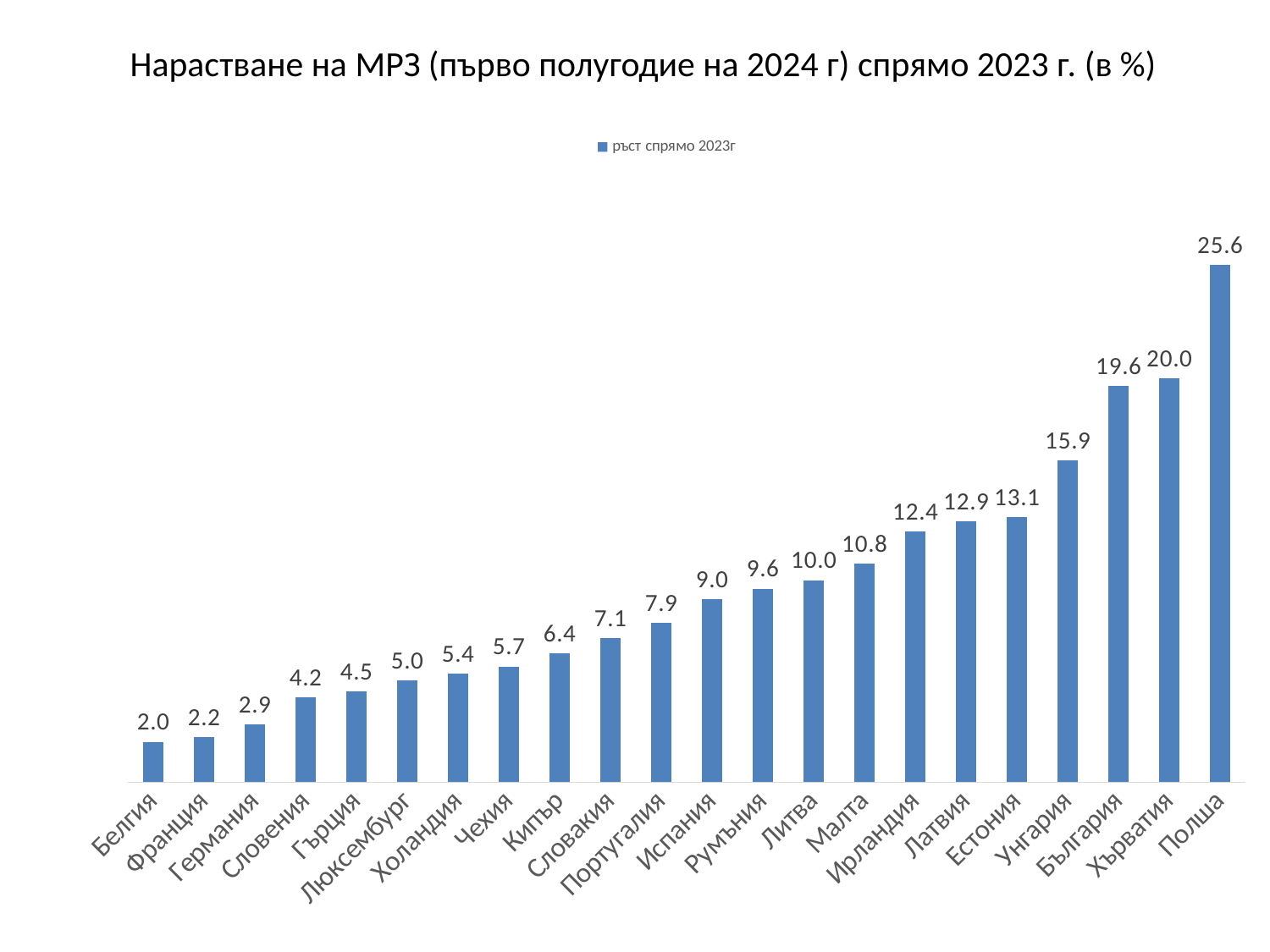
What is the value for Гърция? 4.5 How many countries are shown on the chart? 22 Which country has the highest value? Полша Which is larger, the value for Ирландия or the value for Малта? Ирландия Do the values rise or fall from left to right along the x axis? rise What kind of chart is shown? bar chart Which country has the lowest value? Белгия What is the value for Румъния? 9.6 What is the difference between the values for Унгария and Естония? 2.8 What is the difference between the values for Полша and Хърватия? 5.6 What is the value for България? 19.6 How many series does the legend list? 1